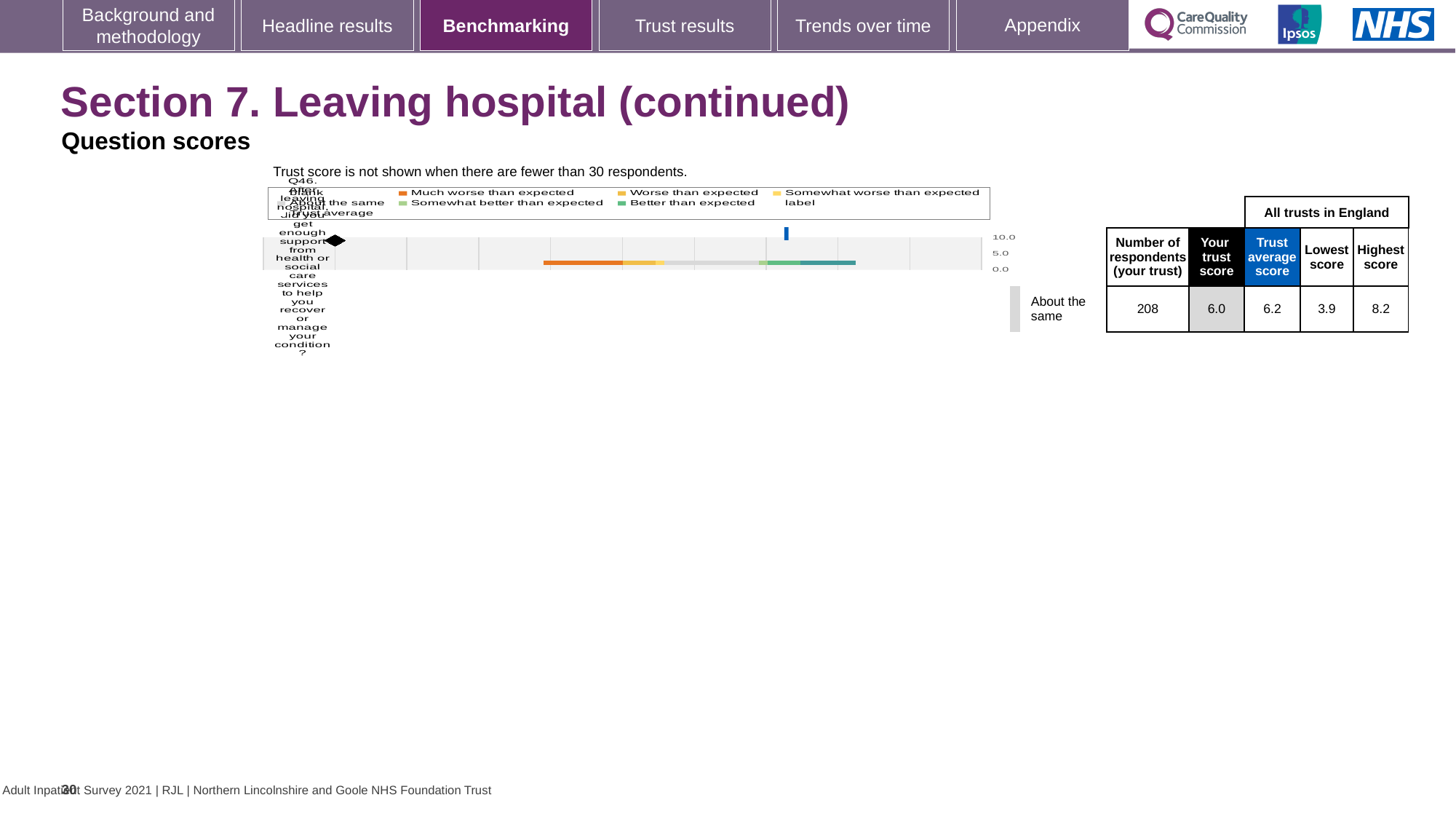
What benchmark category is the trust's Q46 score given on the slide? About the same What is the difference between the trust average score and the trust score for Q46? 0.2 What is the difference between the highest and lowest scores for Q46? 4.3 What is the trust score for Q46 shown alongside the chart? 6.0 How many questions are plotted in the chart? 1 What is the trust average score for Q46? 6.2 What is the highest score among all trusts in England for Q46? 8.2 What kind of chart is shown on the slide? bar chart Which is larger for Q46, the trust score or the trust average score? Trust average score What is the lowest score among all trusts in England for Q46? 3.9 Is the trust score for Q46 greater or less than 5.0 on the chart axis? greater How many respondents from the trust answered Q46? 208